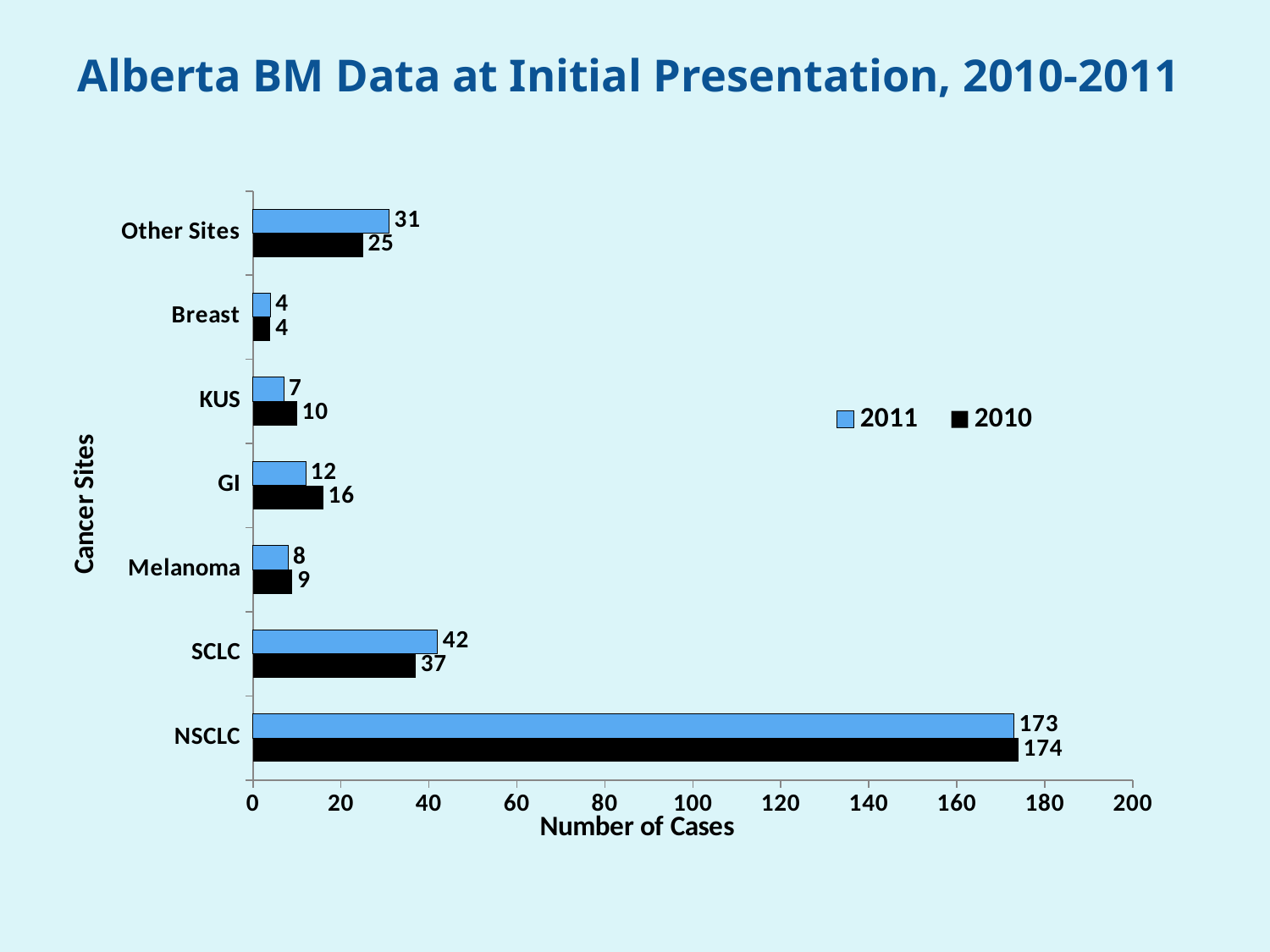
What kind of chart is shown on the slide? bar chart Which cancer site has the highest number of cases in 2010? NSCLC How many cancer site categories are shown on the chart? 7 What is the number of cases for NSCLC in 2011? 173 Which cancer site has the lowest number of cases in 2011? Breast Which is larger for KUS: the 2011 value or the 2010 value? 2010 What is the difference between the 2011 and 2010 values for SCLC? 5 What is the number of cases for GI in 2010? 16 Is the value for NSCLC in 2010 greater or less than 160? greater How many series does the legend list? 2 What is the number of cases for Other Sites in 2010? 25 What is the label of the x axis? Number of Cases